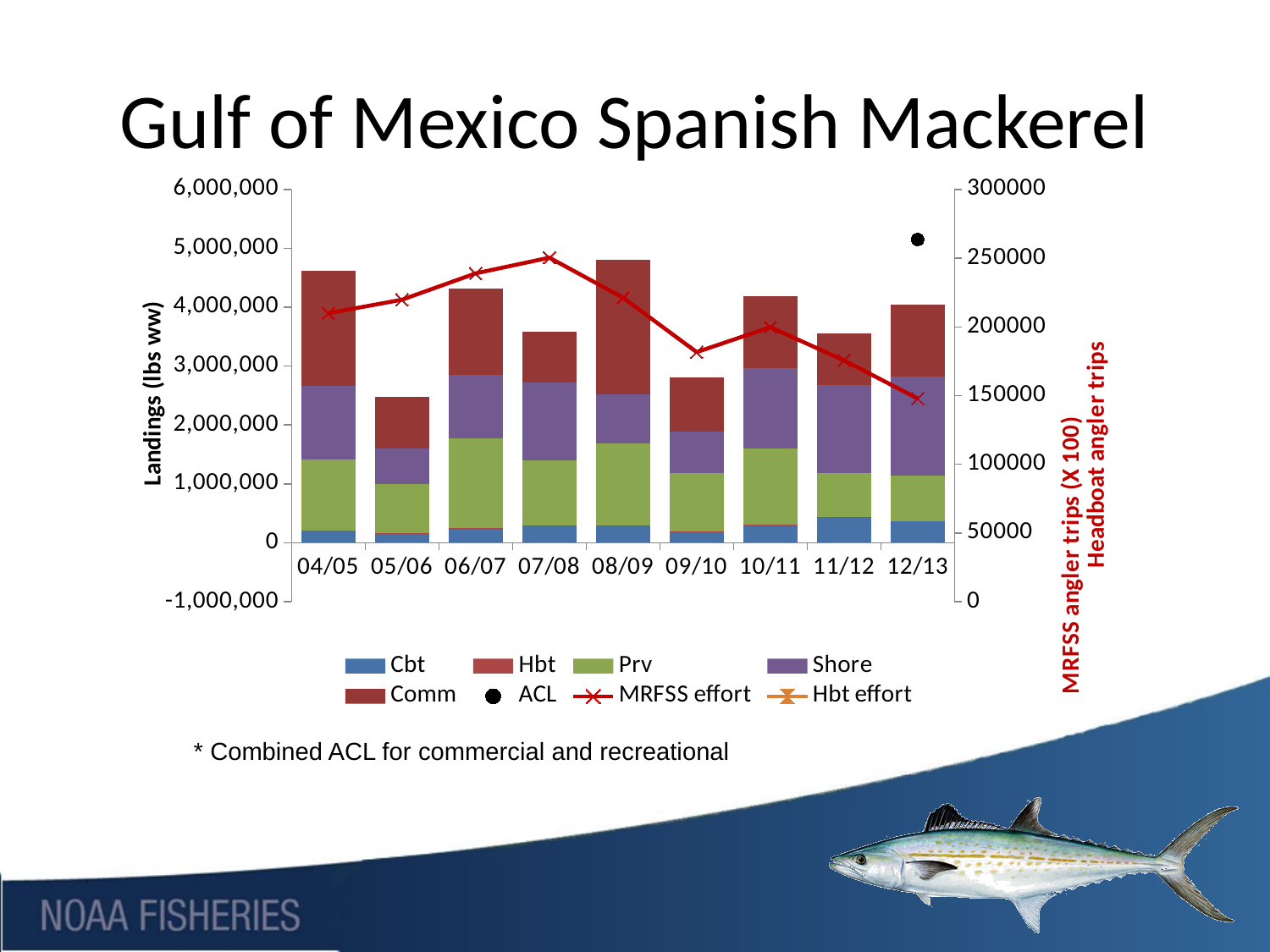
Is the total landings bar for 05/06 greater or less than 3,000,000 lbs? less Is the total landings bar for 08/09 greater or less than 4,000,000 lbs? greater What is the title of the chart? Gulf of Mexico Spanish Mackerel How many fishing years are shown on the x axis? 9 Is the MRFSS effort value for 07/08 greater or less than 200000? greater How many entries does the legend list? 8 In which fishing year is the MRFSS effort line at its lowest point? 12/13 Which fishing year has the larger total landings bar, 08/09 or 05/06? 08/09 Which fishing year has the lowest total landings bar? 05/06 In which fishing year does the MRFSS effort line reach its highest point? 07/08 Does the MRFSS effort line generally rise or fall from 07/08 to 12/13? fall What kind of chart is used to show the landings? bar chart